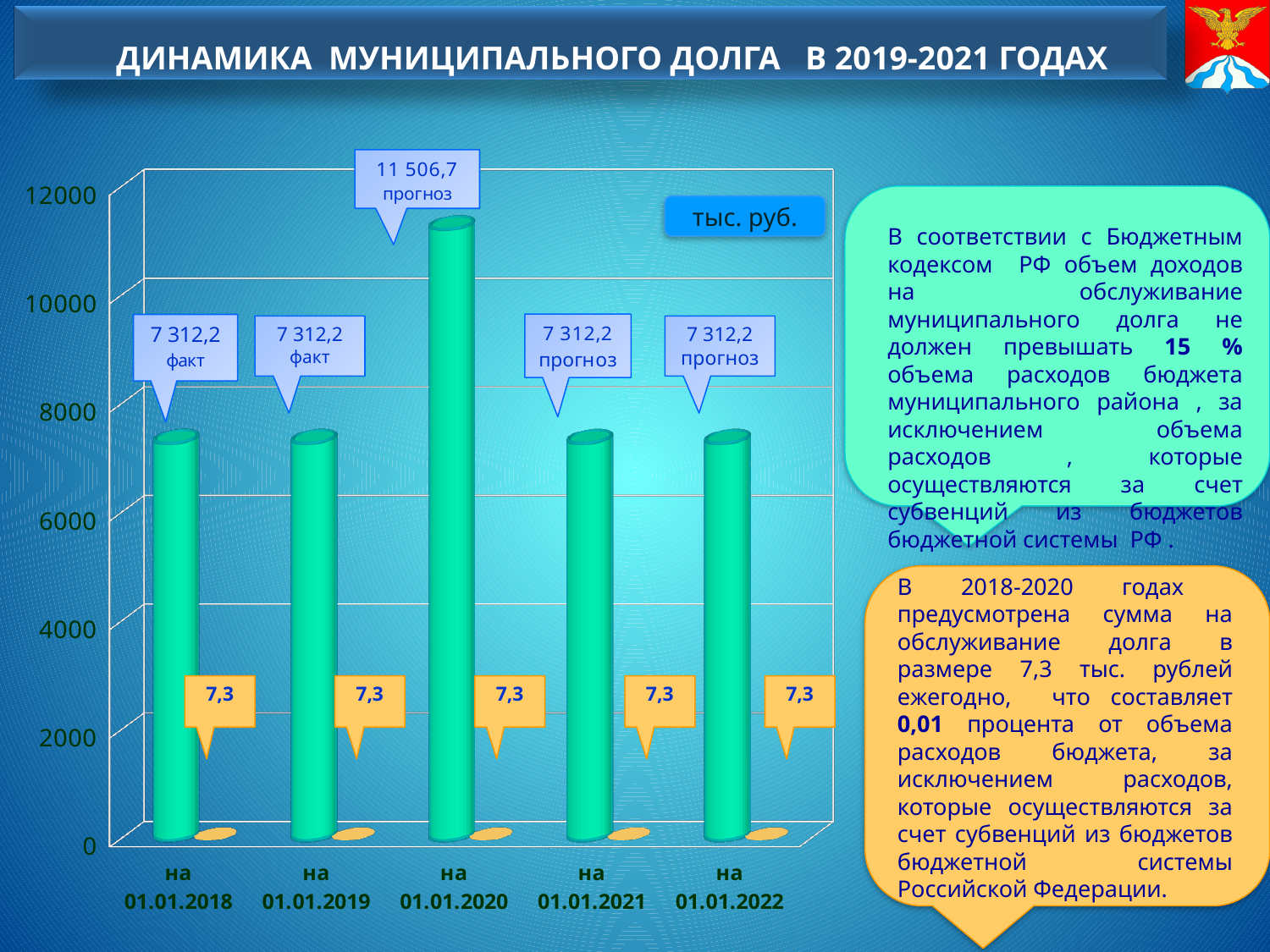
How many dates (categories) are shown on the x axis of the chart? 5 What value is shown in the orange label for each date on the chart? 7,3 Is the municipal debt value for на 01.01.2021 greater or less than 8000? less What is the municipal debt value shown for на 01.01.2022? 7 312,2 What unit of measurement is indicated on the chart? тыс. руб. What is the municipal debt value shown for на 01.01.2018? 7 312,2 What is the difference between the municipal debt value for на 01.01.2020 and the value for на 01.01.2021? 4 194,5 Which is larger: the municipal debt value for на 01.01.2020 or for на 01.01.2019? на 01.01.2020 Which date has the highest municipal debt value on the chart? на 01.01.2020 Is the municipal debt value for на 01.01.2020 greater or less than 10000? greater What is the municipal debt value shown for на 01.01.2020? 11 506,7 What kind of chart is shown on the slide? bar chart